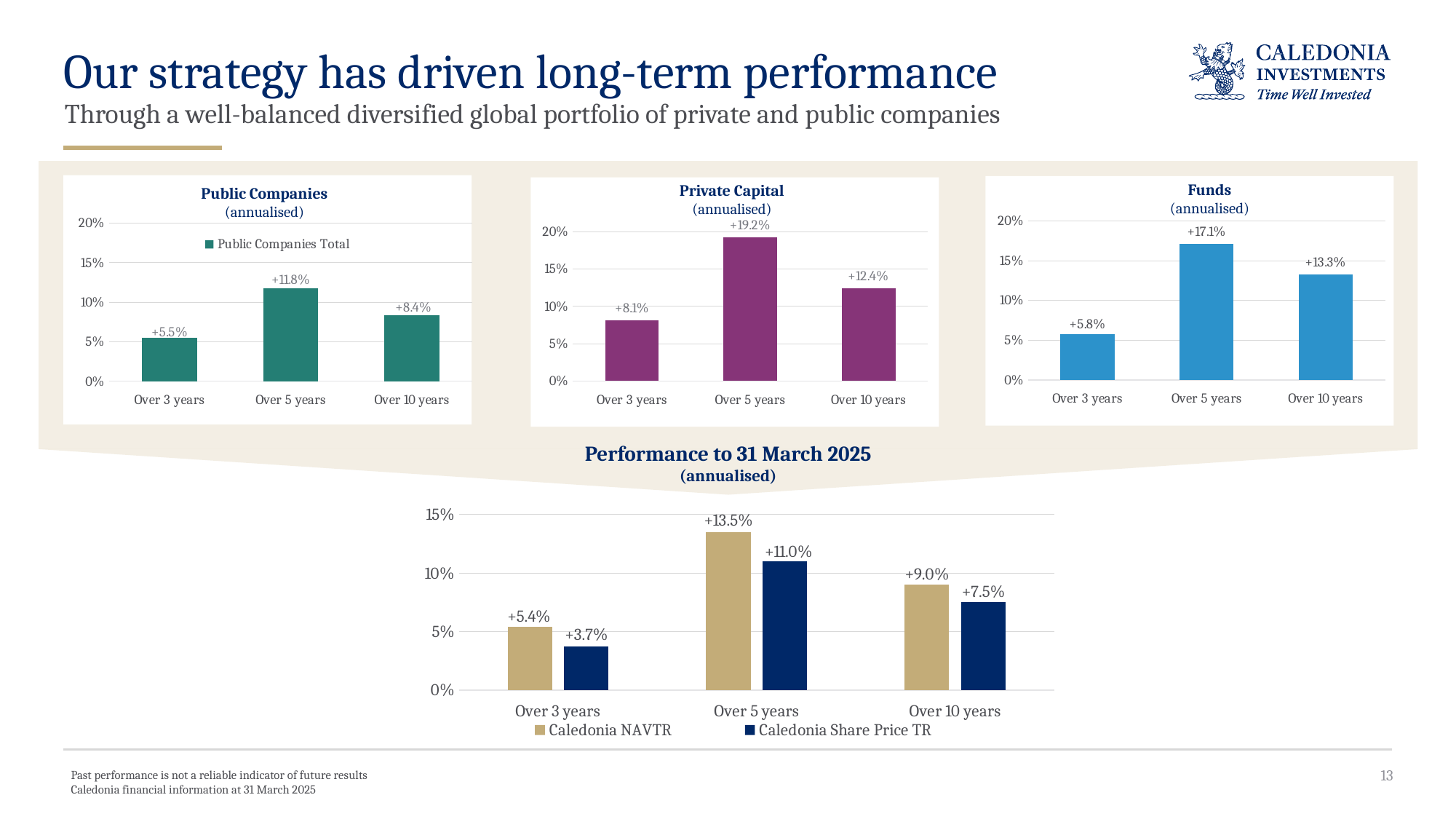
What kind of chart is the Funds chart? Bar chart In the Performance to 31 March 2025 chart, which is larger for Over 10 years: Caledonia NAVTR or Caledonia Share Price TR? Caledonia NAVTR In the Funds chart, which period has the highest value? Over 5 years In the Performance to 31 March 2025 chart, what is the Caledonia Share Price TR value for Over 3 years? +3.7% How many categories are shown in the Public Companies chart? 3 In the Performance to 31 March 2025 chart, what is the difference between Caledonia NAVTR and Caledonia Share Price TR for Over 5 years? 2.5% In the Public Companies chart, what is the value for Over 5 years? +11.8% In the Private Capital chart, which period has the lowest value? Over 3 years In the Funds chart, what is the difference between the Over 5 years and Over 10 years values? 3.8% How many series does the legend of the Performance to 31 March 2025 chart list? 2 In the Private Capital chart, what is the value for Over 10 years? +12.4% In the Private Capital chart, is the value for Over 5 years greater or less than 15%? greater